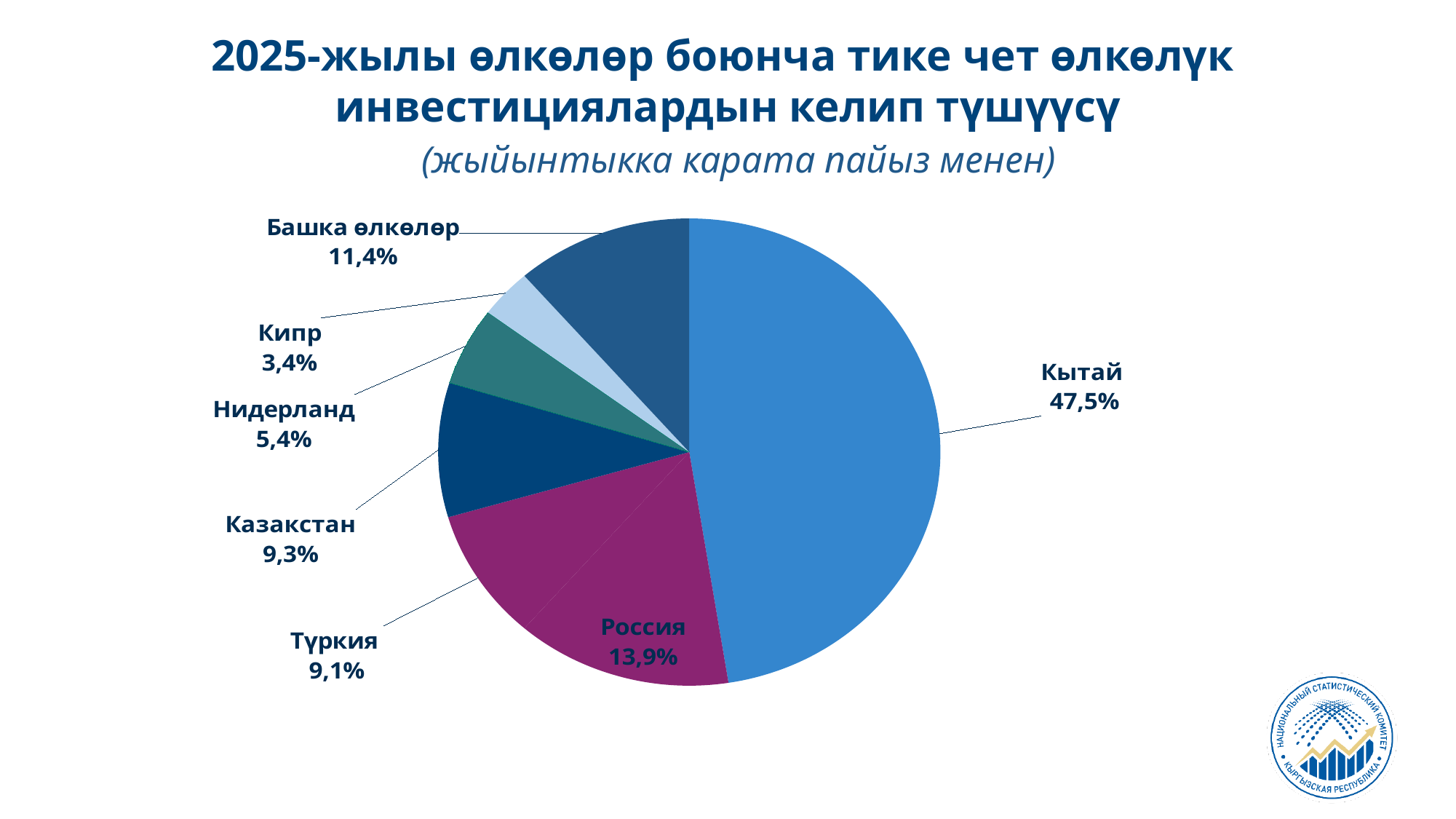
How many slices does the pie chart have? 7 What is the value shown for Россия? 13,9% What is the difference in percentage points between Башка өлкөлөр and Нидерланд? 6,0 Which is larger, the share for Россия or the share for Башка өлкөлөр? Россия What is the value shown for Башка өлкөлөр? 11,4% What share of the pie does Кытай have? 47,5% What is the value shown for Нидерланд? 5,4% Which category has the smallest slice of the pie? Кипр What is the difference in percentage points between Кытай and Россия? 33,6 Which country has the largest slice of the pie? Кытай What year is named in the chart title? 2025 What kind of chart is shown on the slide? pie chart